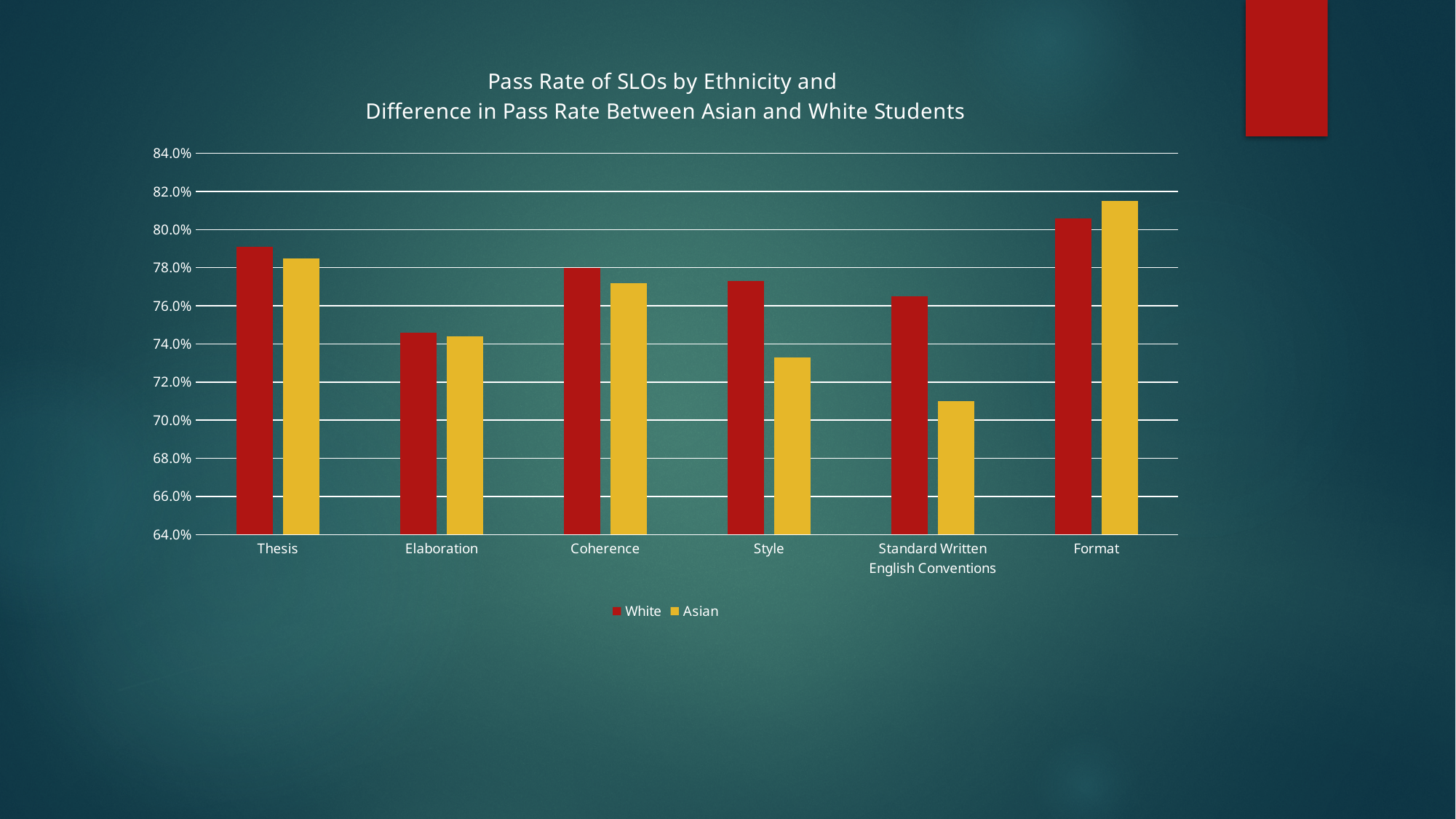
Which colour represents Asian students in the chart? yellow Is the White pass rate for Format greater or less than 80.0%? greater What kind of chart is shown on the slide? bar chart For Format, which group has the higher pass rate, White or Asian? Asian How many series does the legend list? 2 Which category has the highest pass rate for White students? Format For Style, which group has the higher pass rate, White or Asian? White Which category has the highest pass rate for Asian students? Format Is the Asian pass rate for Standard Written English Conventions greater or less than 72.0%? less How many SLO categories are shown on the x axis? 6 Which category has the lowest pass rate for Asian students? Standard Written English Conventions Is the Asian pass rate for Style greater or less than 74.0%? less